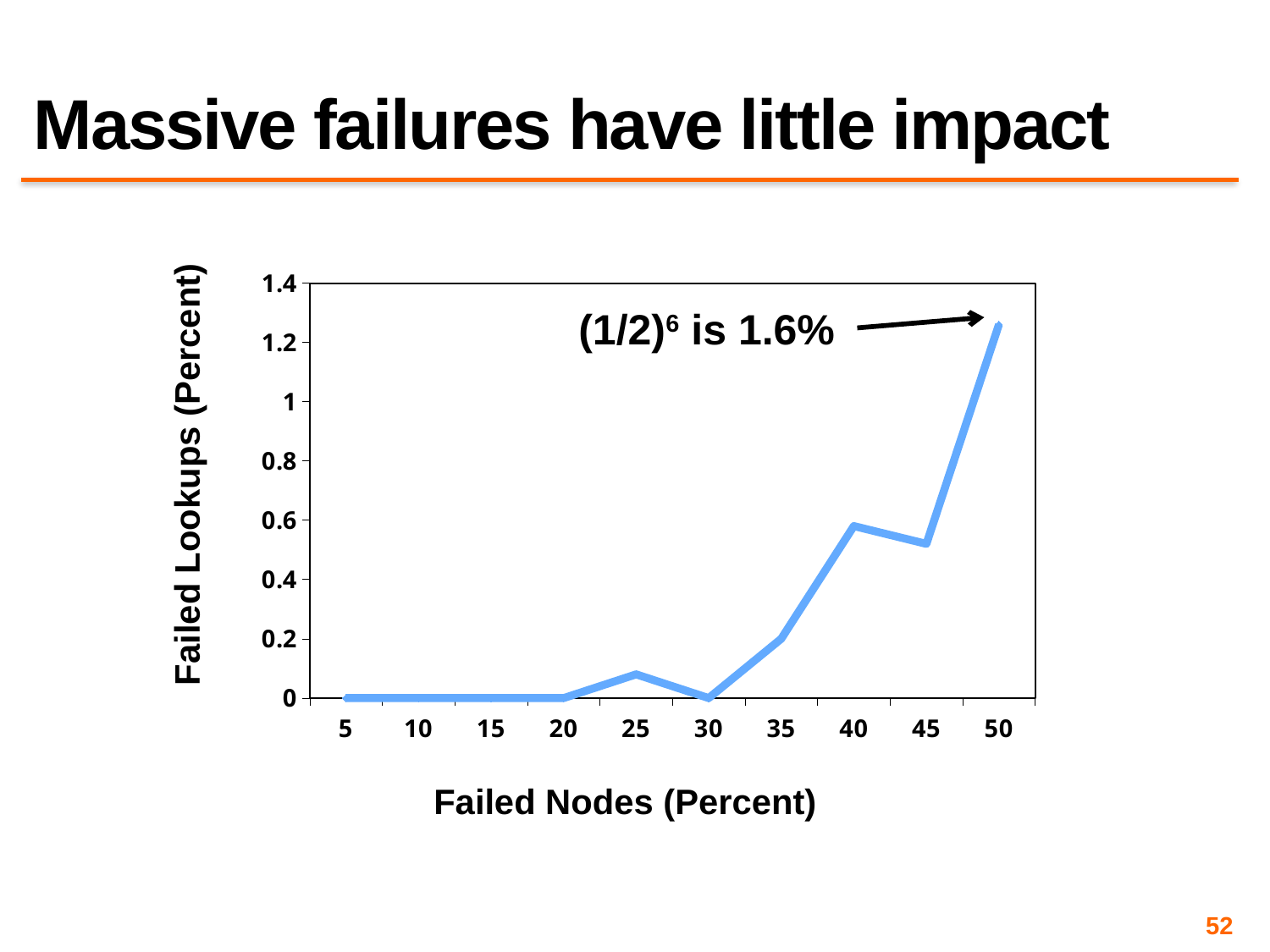
What kind of chart is shown on the slide? line chart Is the failed lookups value at 40 percent failed nodes greater or less than 0.4? greater Is the failed lookups value at 50 percent failed nodes greater or less than 1? greater At which percentage of failed nodes is the failed lookups value highest? 50 What is the title of the y axis? Failed Lookups (Percent) What is the failed lookups value when 10 percent of nodes have failed? 0 Overall, do failed lookups rise or fall as the percentage of failed nodes increases? rise Which has a higher failed lookups value: 40 percent failed nodes or 50 percent failed nodes? 50 Is the failed lookups value at 25 percent failed nodes greater or less than 0.2? less How many data points are plotted on the line? 10 What is the failed lookups value when 30 percent of nodes have failed? 0